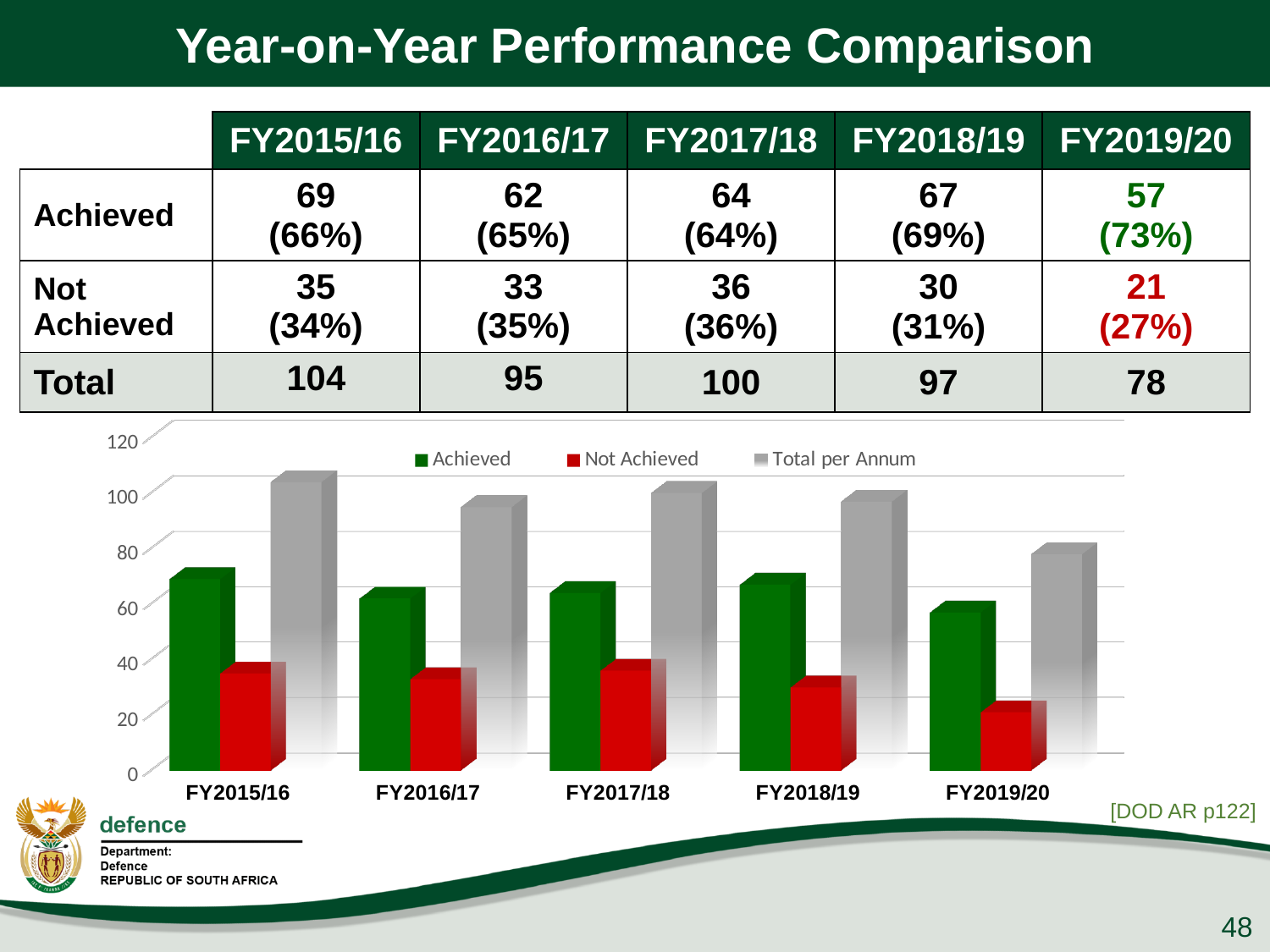
How many series does the chart legend list? 3 What is the Not Achieved value for FY2019/20? 21 What is the Total per Annum value for FY2017/18? 100 Is the Total per Annum bar for FY2019/20 greater or less than 80? less Which financial year has the lowest Achieved value? FY2019/20 What is the difference between the Achieved and Not Achieved values for FY2018/19? 37 Which financial year has the highest Total per Annum? FY2015/16 How many financial years are shown on the x axis of the chart? 5 What colour are the Not Achieved bars in the chart? red What kind of chart is shown on the slide? bar chart Which is larger, the Not Achieved value for FY2017/18 or for FY2018/19? FY2017/18 What is the Achieved value for FY2015/16? 69